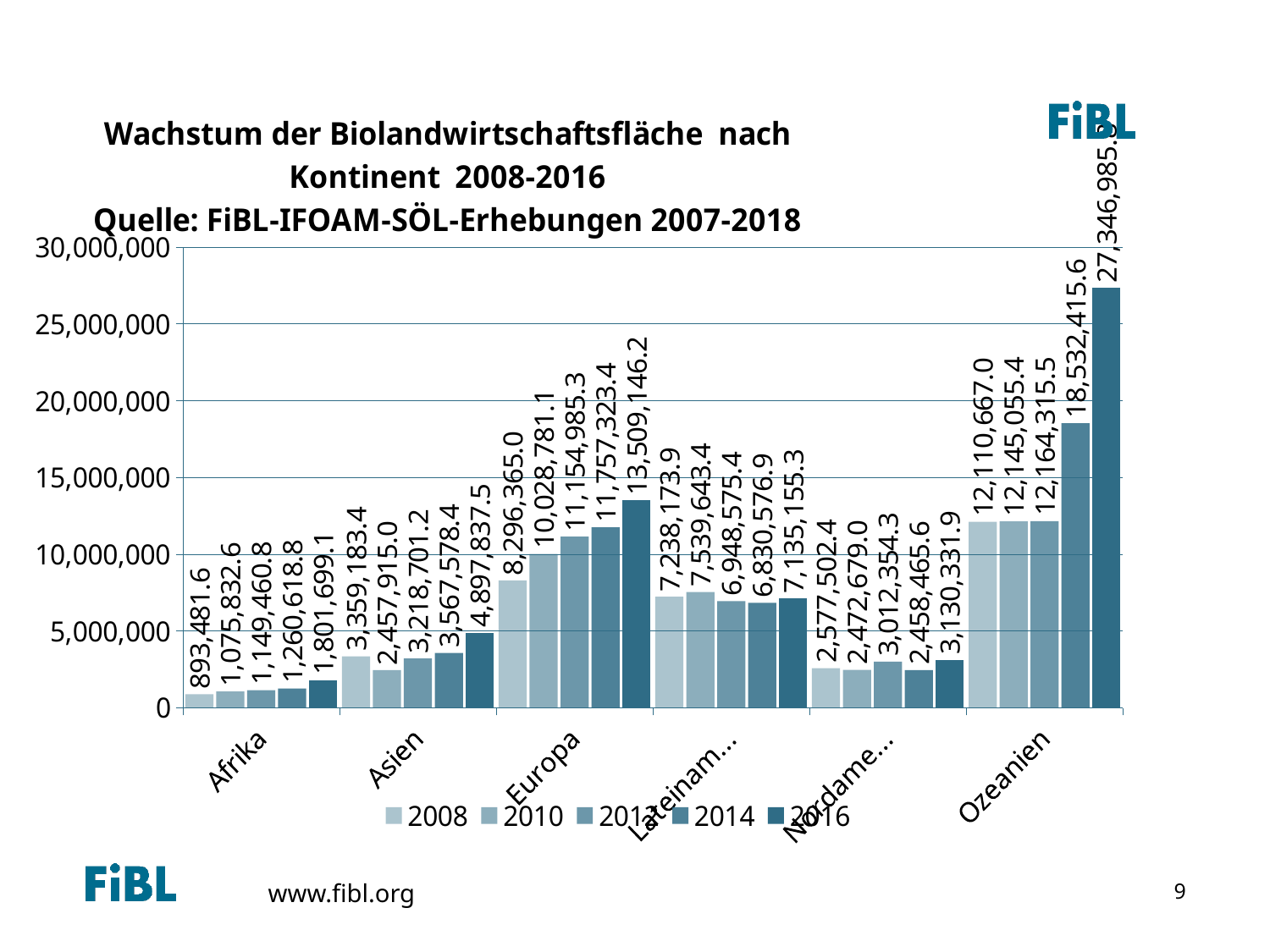
What kind of chart is shown on the slide? bar chart How many continent categories are shown on the x axis? 6 Which is larger: the value for Asien in 2016 or the value for Europa in 2008? Europa in 2008 What is the value for Afrika in 2016? 1,801,699.1 Do the values for Afrika rise or fall from 2008 to 2016? rise What is the difference between the Europa value in 2016 and in 2008? 5,212,781.2 How many series does the legend list? 5 Which continent has the highest value in 2016? Ozeanien What is the value for Europa in 2008? 8,296,365.0 What is the value for Ozeanien in 2014? 18,532,415.6 Is the value for Ozeanien in 2016 greater or less than 25,000,000? greater Which continent has the lowest value in 2008? Afrika